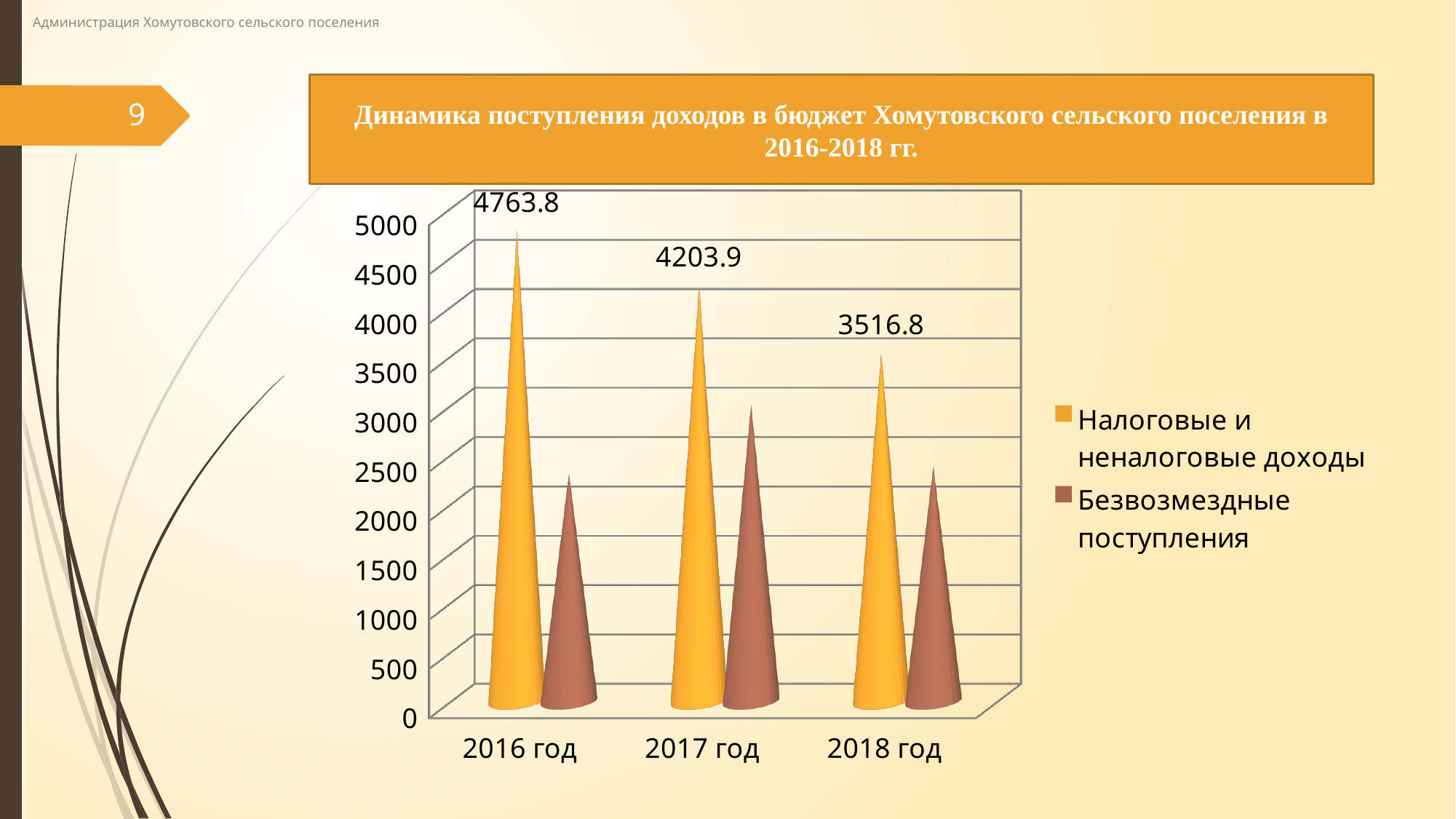
What is the value of Налоговые и неналоговые доходы for 2016 год? 4763.8 In which year is the value of Налоговые и неналоговые доходы the lowest? 2018 год What is the value of Налоговые и неналоговые доходы for 2017 год? 4203.9 What is the difference between the Налоговые и неналоговые доходы values for 2016 год and 2017 год? 559.9 How many series does the legend list? 2 Is the value of Безвозмездные поступления for 2017 год greater or less than 2500? greater In which year is the value of Налоговые и неналоговые доходы the highest? 2016 год What is the difference between the Налоговые и неналоговые доходы values for 2017 год and 2018 год? 687.1 For 2016 год, which is larger: Налоговые и неналоговые доходы or Безвозмездные поступления? Налоговые и неналоговые доходы Do the values of Налоговые и неналоговые доходы rise or fall from 2016 год to 2018 год? fall What is the value of Налоговые и неналоговые доходы for 2018 год? 3516.8 How many years are shown on the x axis of the chart? 3